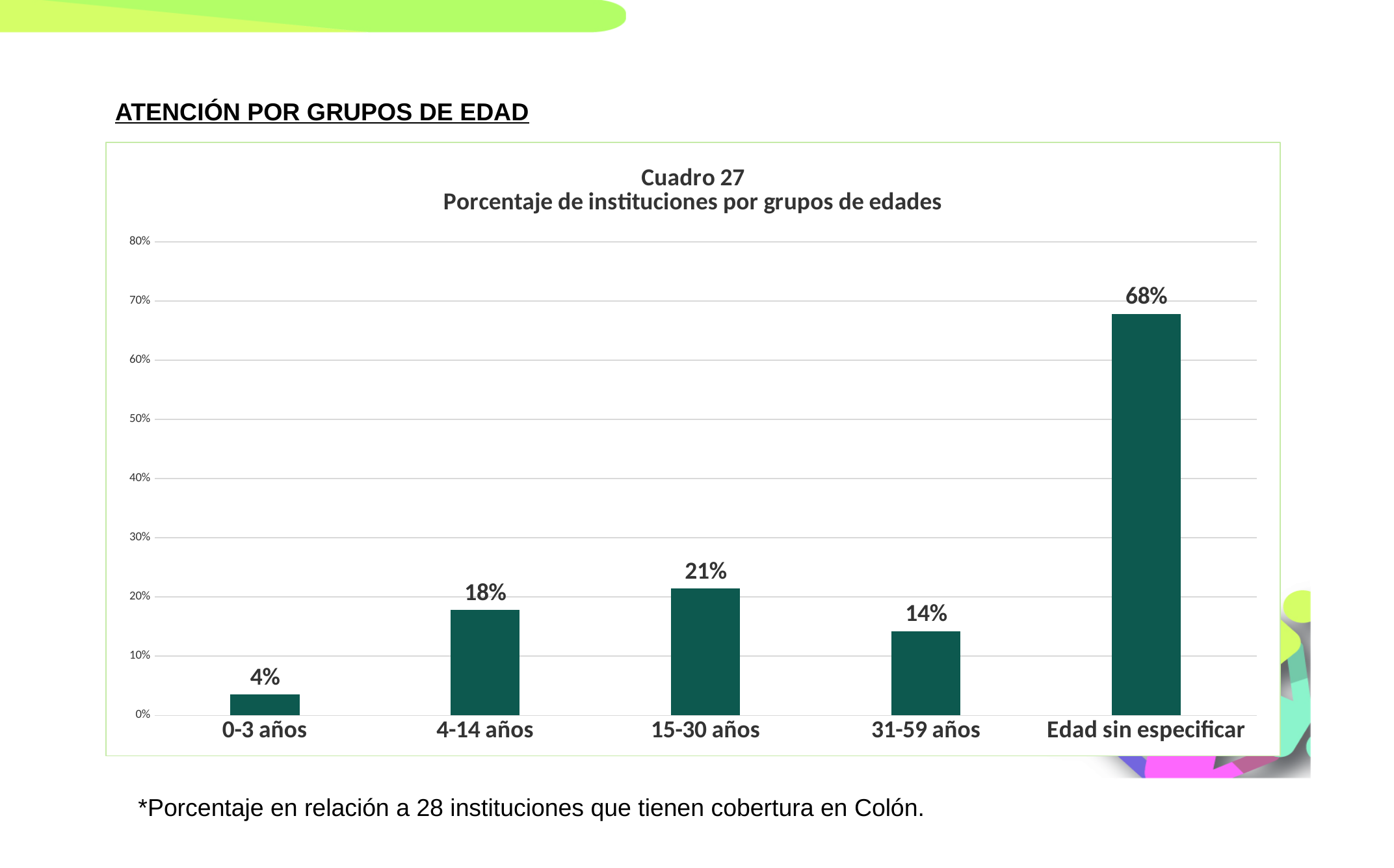
Which category has the highest value? Edad sin especificar What kind of chart is shown? bar chart What is the title of the chart? Cuadro 27 Porcentaje de instituciones por grupos de edades How many age-group categories are shown on the x axis? 5 Which category has the lowest value? 0-3 años What is the value for 4-14 años? 18% Which is larger, the value for 4-14 años or the value for 31-59 años? 4-14 años What is the value for 0-3 años? 4% Is the value for 31-59 años greater or less than 20%? less What is the value for Edad sin especificar? 68% What is the value for 15-30 años? 21% What is the difference between the values for Edad sin especificar and 15-30 años? 47%